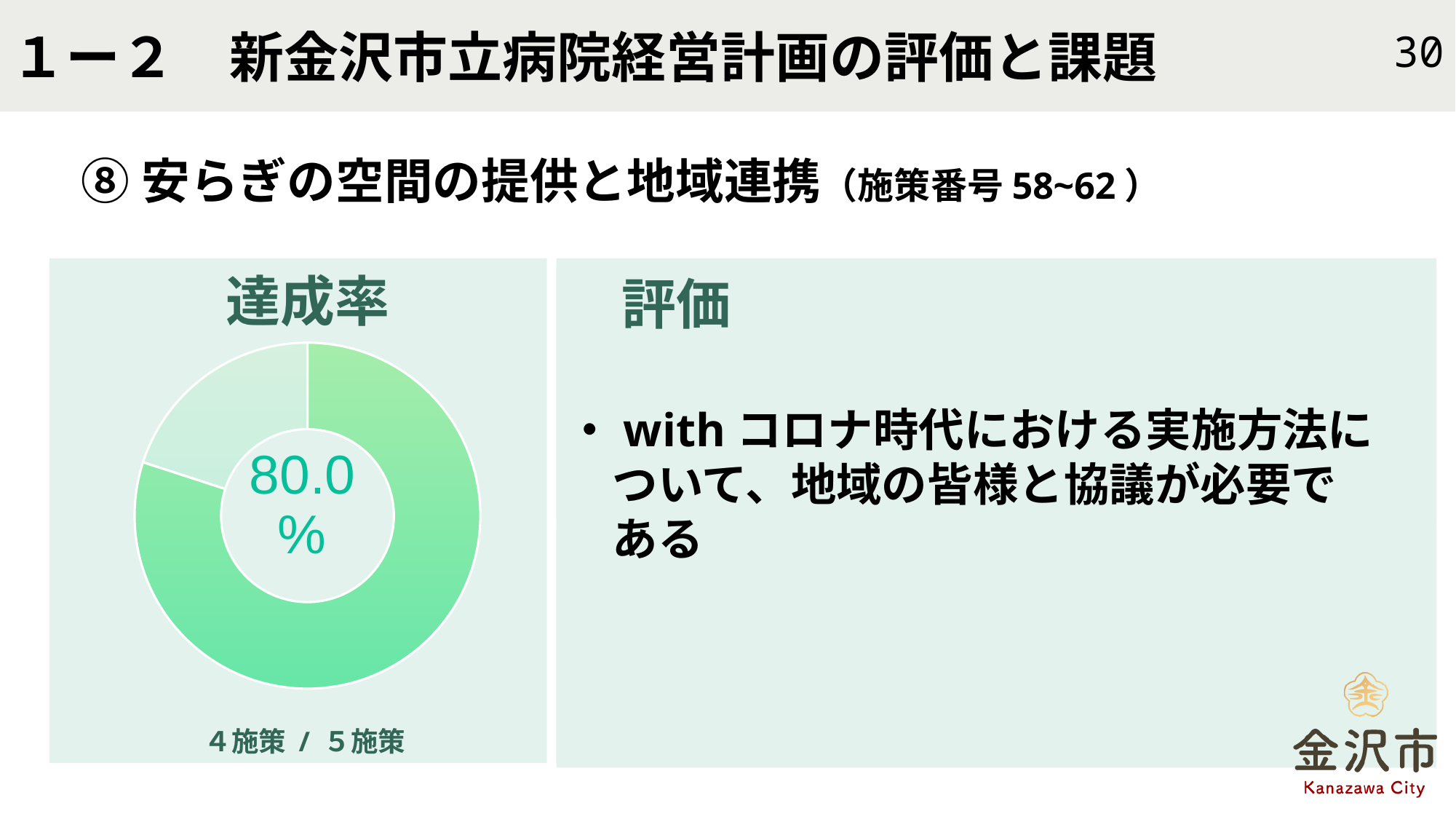
What value is printed in the centre of the 達成率 chart? 80.0% What type of chart is shown under 達成率? pie chart (donut) How many slices does the 達成率 donut chart have? 2 According to the label below the 達成率 chart, how many measures were achieved out of how many? 4施策 / 5施策 What text is printed below the 達成率 chart? 4施策 / 5施策 What share of the 達成率 chart does the larger (darker green) slice represent? 80.0% Is the achievement rate shown in the 達成率 chart greater or less than 50%? greater What is the title of the chart on the left of the slide? 達成率 In the 達成率 chart, which slice is larger: the darker green slice or the lighter green slice? the darker green slice